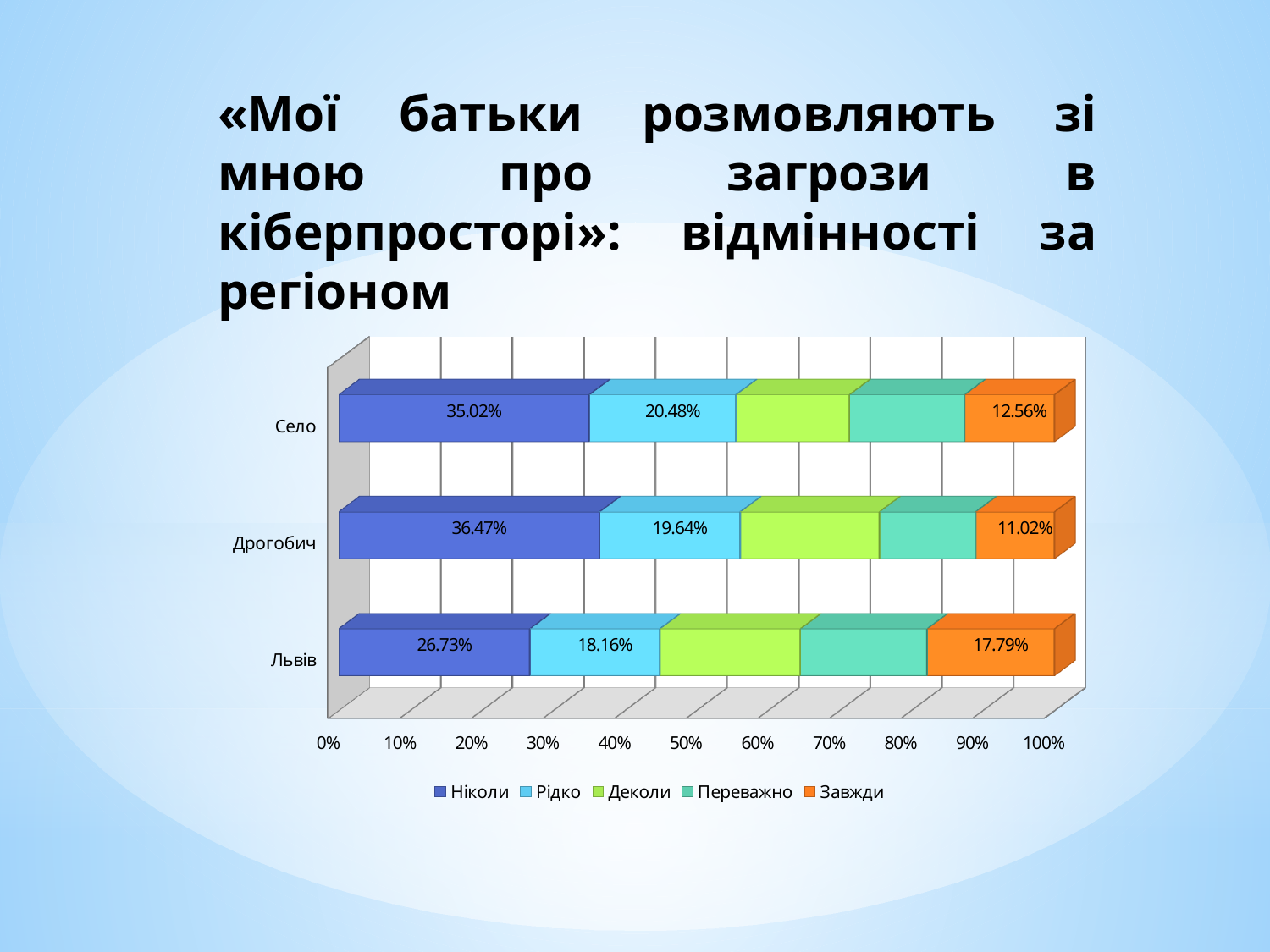
What is the value for Рідко for Дрогобич? 19.64% Which is larger: the Завжди value for Львів or for Село? Львів What is the value for Ніколи for Село? 35.02% Which region has the highest value for Ніколи? Дрогобич What is the value for Завжди for Львів? 17.79% What is the difference between the Ніколи values for Село and Львів? 8.29% How many regions are shown on the chart? 3 Which series is shown in orange in the legend? Завжди Which region has the lowest value for Ніколи? Львів How many series does the legend list? 5 Which region has the lowest value for Завжди? Дрогобич What kind of chart is shown on the slide? Stacked bar chart